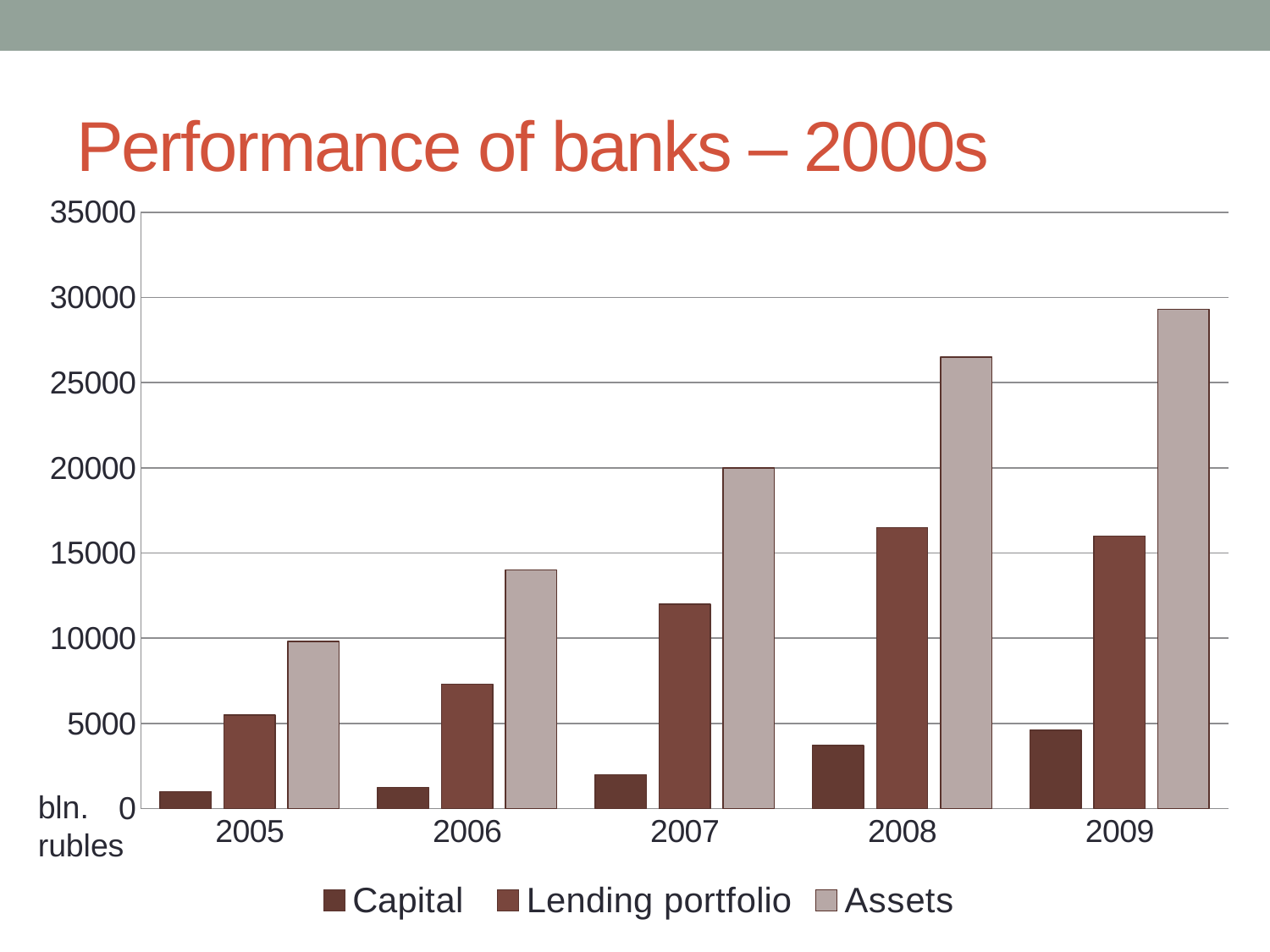
What kind of chart is shown on the slide? bar chart Is the Capital value for 2009 greater or less than 5000? less Which year has the lowest Capital bar? 2005 Is the Lending portfolio value for 2006 greater or less than 5000? greater How many years are shown on the x axis? 5 Which series has the tallest bar in 2009? Assets Which is larger: Assets in 2007 or Lending portfolio in 2008? Assets in 2007 Do the Assets values rise or fall from 2005 to 2009? rise How many series does the legend list? 3 Is the Assets value for 2006 greater or less than 15000? less What unit is given for the y axis? bln. rubles